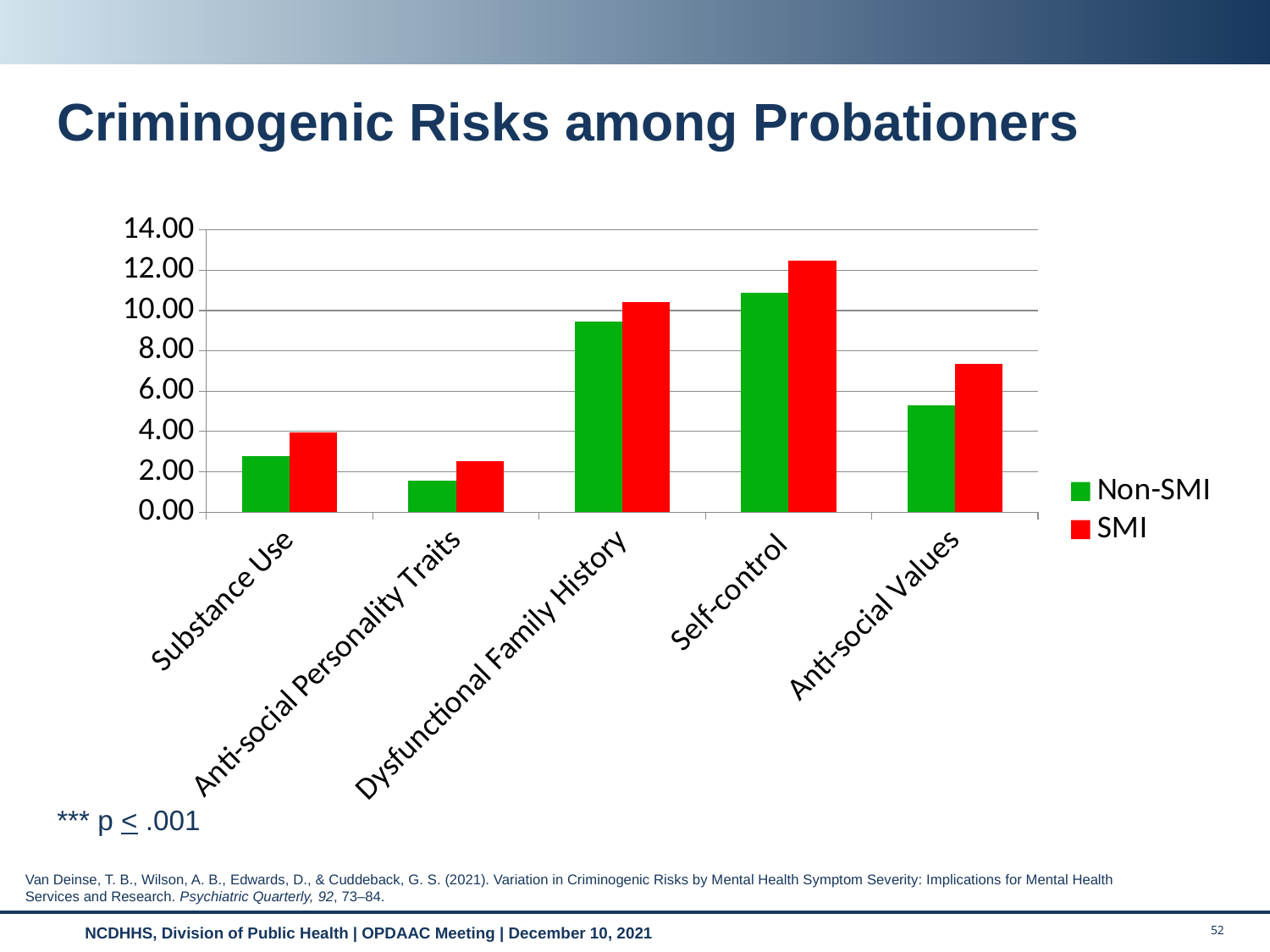
Is the Non-SMI value for Dysfunctional Family History greater or less than 8.00? greater Which category has the highest SMI value? Self-control Is the Non-SMI value for Anti-social Values greater or less than 6.00? less Which category has the lowest Non-SMI value? Anti-social Personality Traits How many risk categories are shown on the x axis? 5 Is the SMI value for Self-control greater or less than 12.00? greater What kind of chart is shown on the slide? Bar chart What colour represents the SMI series in the legend? Red For Substance Use, which group has the larger value, Non-SMI or SMI? SMI For the Non-SMI group, which is larger: Self-control or Dysfunctional Family History? Self-control How many series does the legend list? 2 What is the title of the slide containing the chart? Criminogenic Risks among Probationers